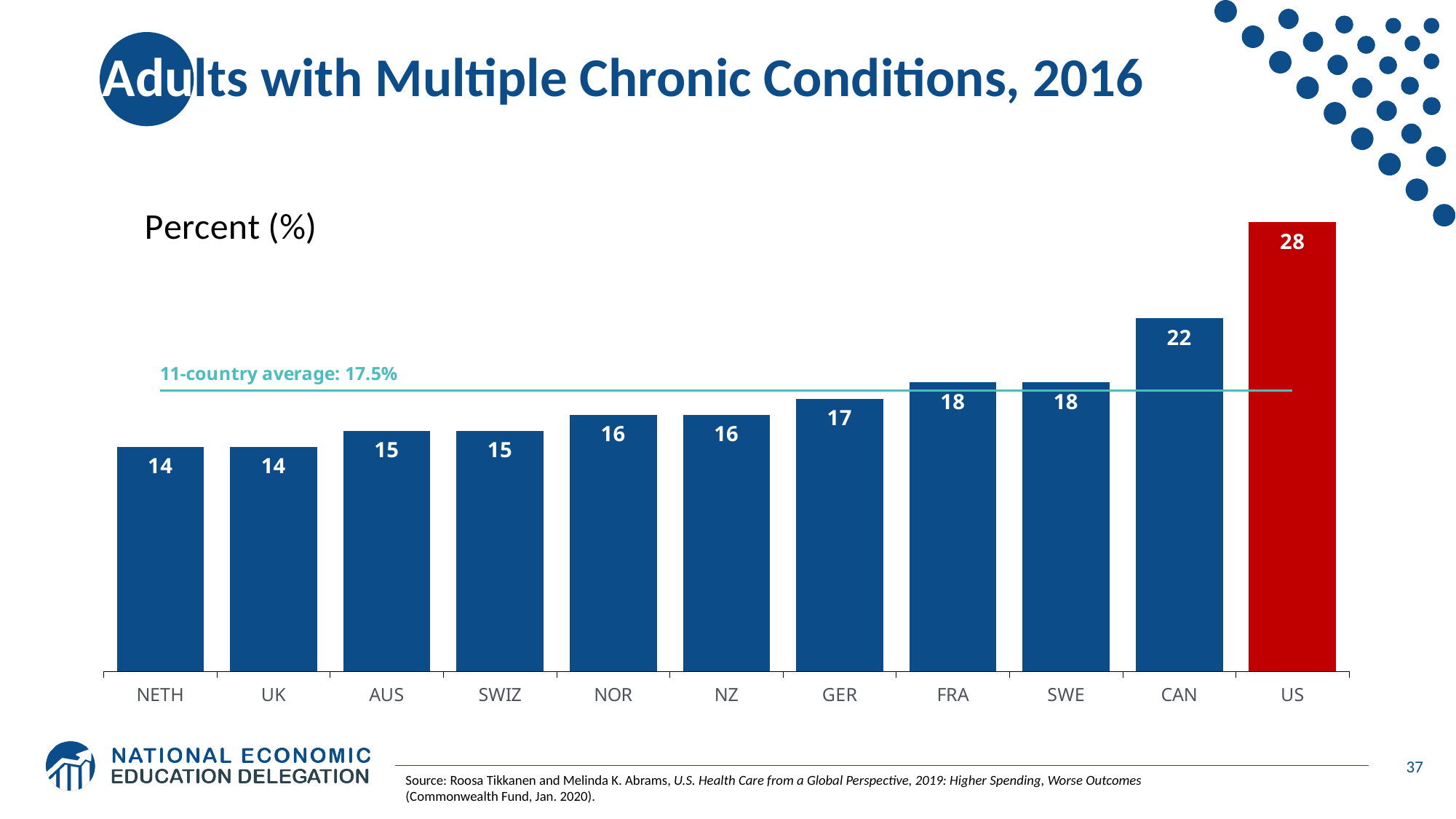
What is the 11-country average shown on the chart? 17.5% Which has a larger value, NOR or FRA? FRA How many countries are shown on the chart? 11 What is the value for GER? 17 Which country's bar is coloured red? US What is the difference between the values for SWE and NETH? 4 What is the value for CAN? 22 What is the difference between the values for the US and CAN? 6 Which country has the highest value? US What is the value for the US? 28 Do the values rise or fall from left to right across the countries? Rise What kind of chart is shown on the slide? Bar chart